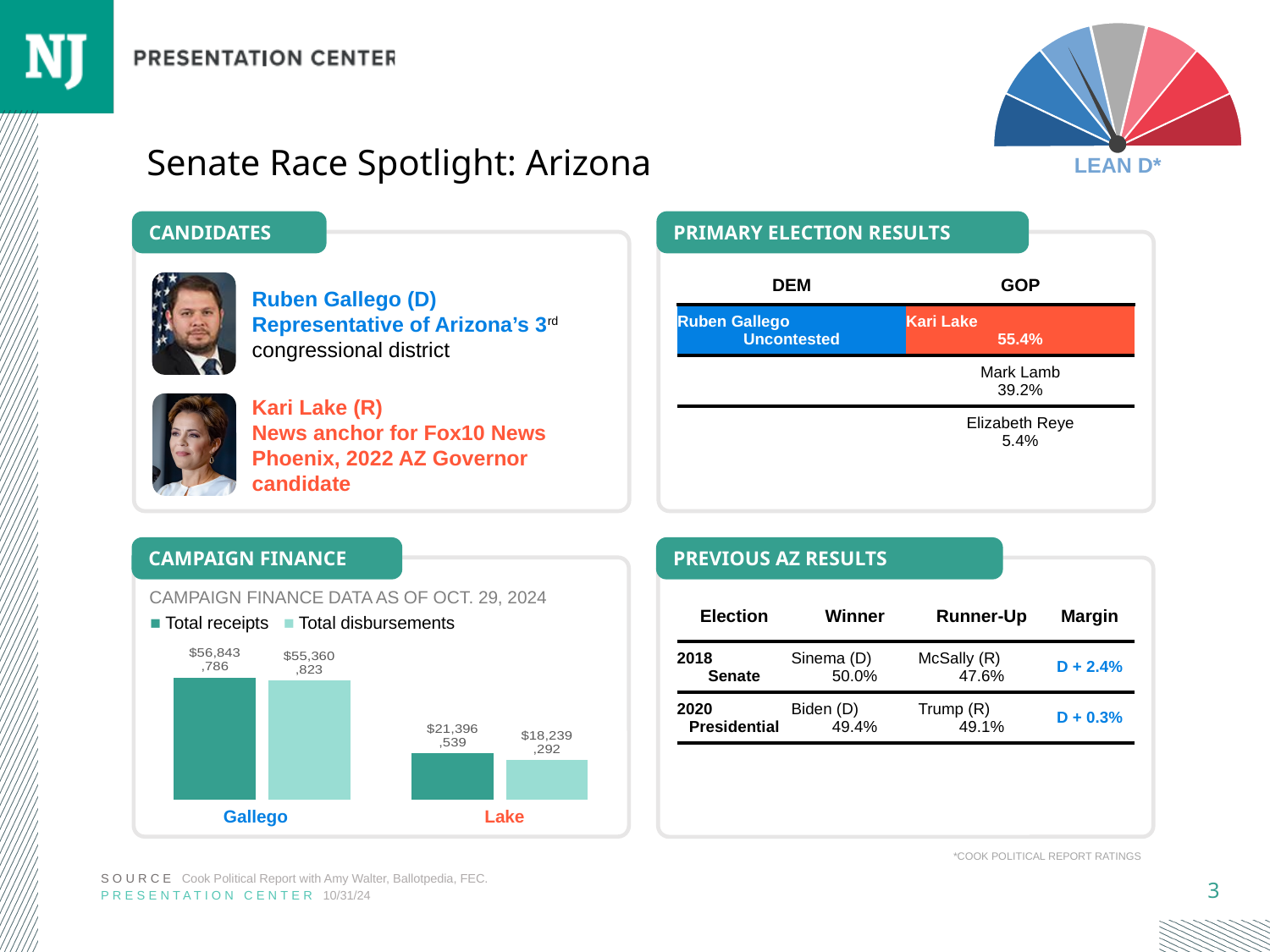
In the Campaign Finance chart, are Gallego's total receipts larger or smaller than his total disbursements? larger In the Campaign Finance chart, which candidate has the higher total receipts? Gallego In the Campaign Finance chart, what are the total disbursements for Gallego? $55,360,823 In the Campaign Finance chart, which candidate has the lower total disbursements? Lake In the Campaign Finance chart, what are the total receipts for Lake? $21,396,539 In the Campaign Finance chart, how much greater are Gallego's total receipts than Lake's total receipts? $35,447,247 In the Campaign Finance chart, what is the difference between Lake's total receipts and total disbursements? $3,157,247 How many candidates are shown on the x axis of the Campaign Finance chart? 2 In the Campaign Finance chart, what are the total receipts for Gallego? $56,843,786 In the Campaign Finance chart, what are the total disbursements for Lake? $18,239,292 What type of chart is used in the Campaign Finance section? bar chart How many series does the legend of the Campaign Finance chart list? 2